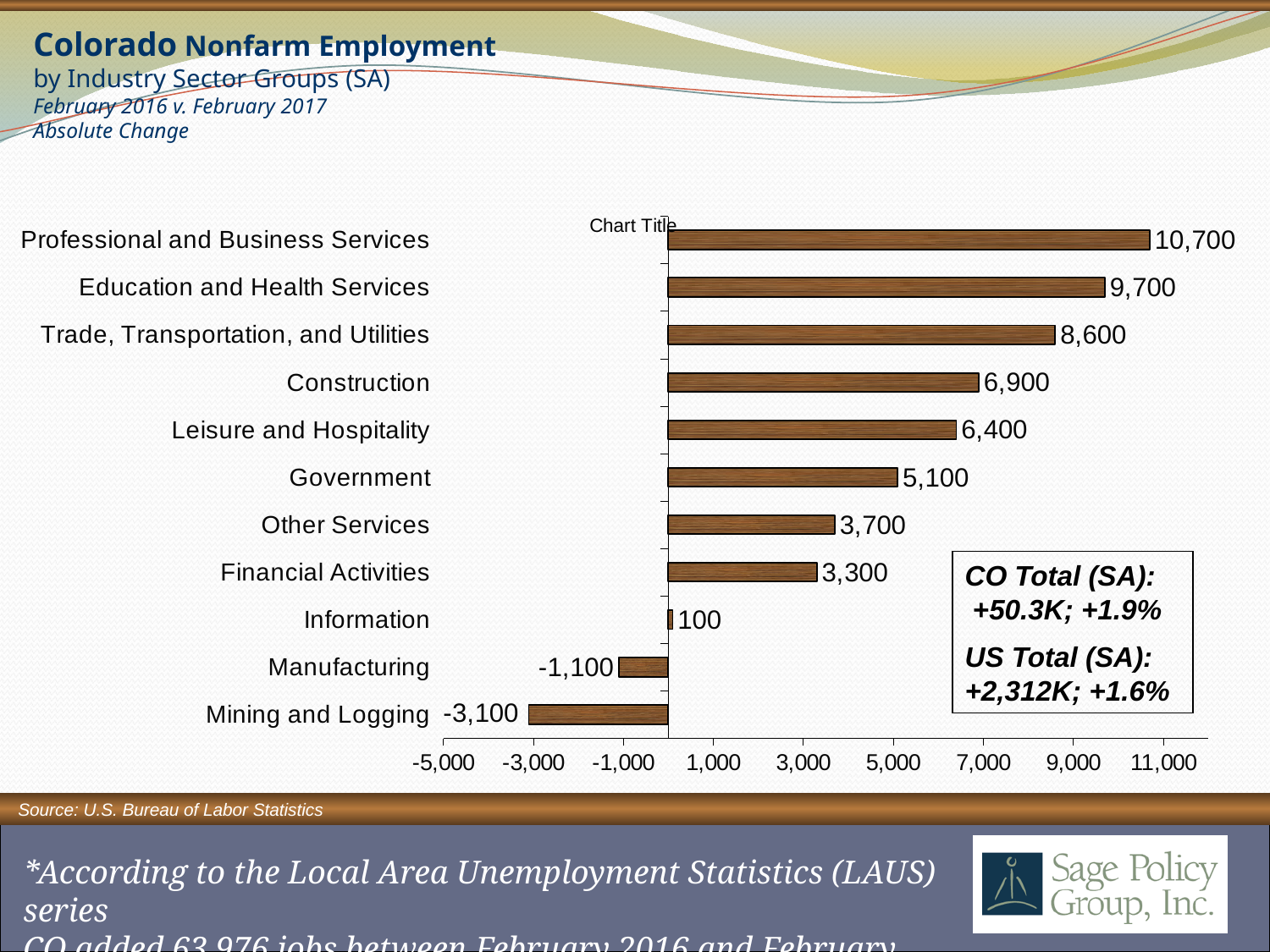
What is the value shown for Government? 5,100 Is the value for Other Services greater or less than 3,000? greater What kind of chart is shown on the slide? Bar chart What is the value shown for Information? 100 Which is larger, the value for Construction or the value for Leisure and Hospitality? Construction How many industry sector groups are shown in the chart? 11 What is the absolute change in employment for Professional and Business Services? 10,700 Which industry sector has the highest absolute change? Professional and Business Services What is the value shown for Mining and Logging? -3,100 How many industry sectors show a negative change? 2 Which industry sector has the lowest absolute change? Mining and Logging What is the difference between the values for Education and Health Services and Trade, Transportation, and Utilities? 1,100